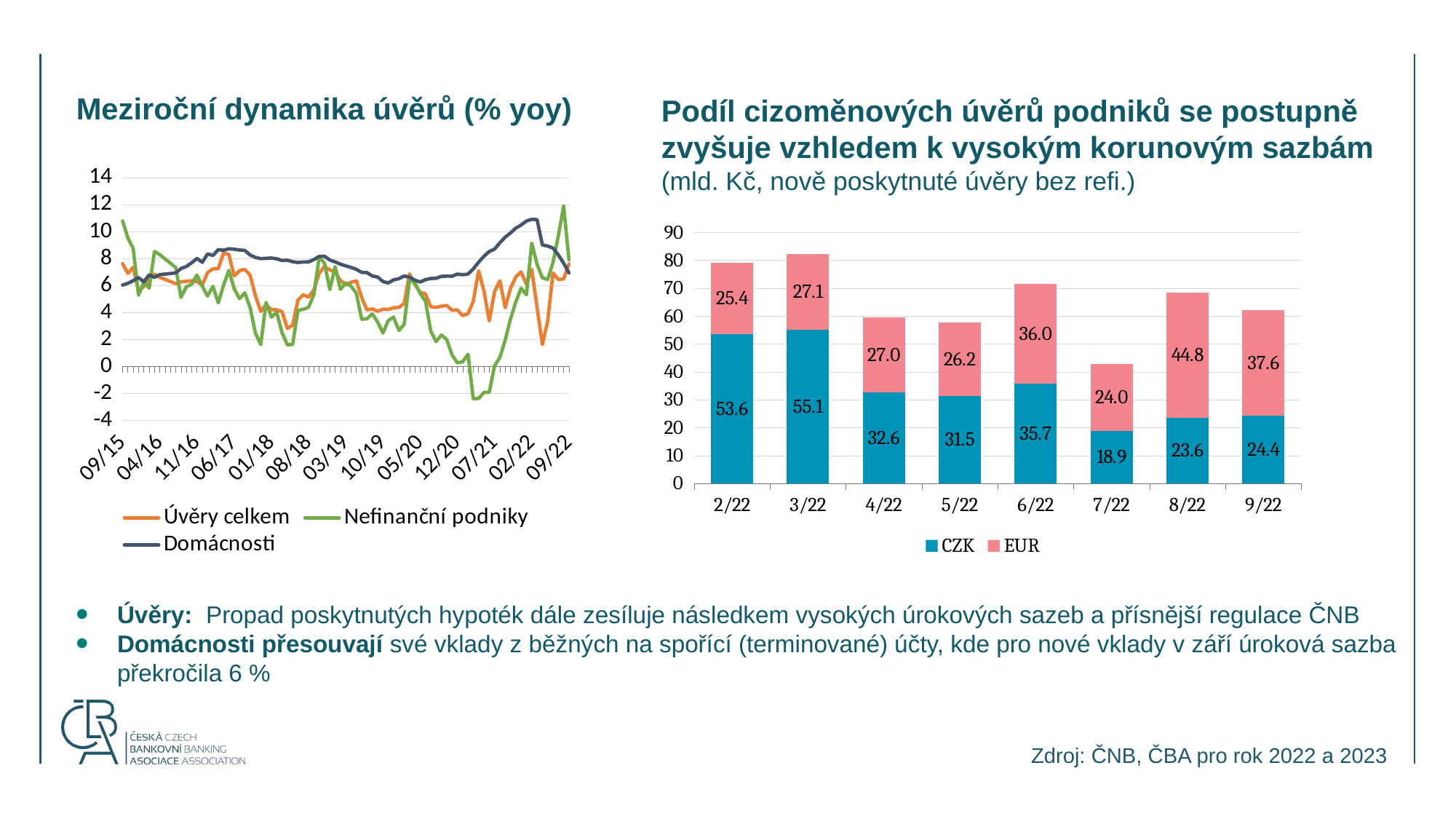
On the right chart, what is the difference between the CZK values for 3/22 and 4/22? 22.5 On the right chart, what is the CZK value for 3/22? 55.1 On the right chart, what is the EUR value for 8/22? 44.8 How many series does the legend of the right chart list? 2 On the right chart, which month has the highest EUR value? 8/22 How many series does the legend of the left chart list? 3 On the right chart, which is larger for 6/22, the CZK value or the EUR value? EUR How many months are shown on the x axis of the right chart? 8 What kind of chart is the left chart titled 'Meziroční dynamika úvěrů (% yoy)'? line chart On the right chart, what is the total of the stacked bar for 2/22? 79.0 On the right chart, which month has the lowest CZK value? 7/22